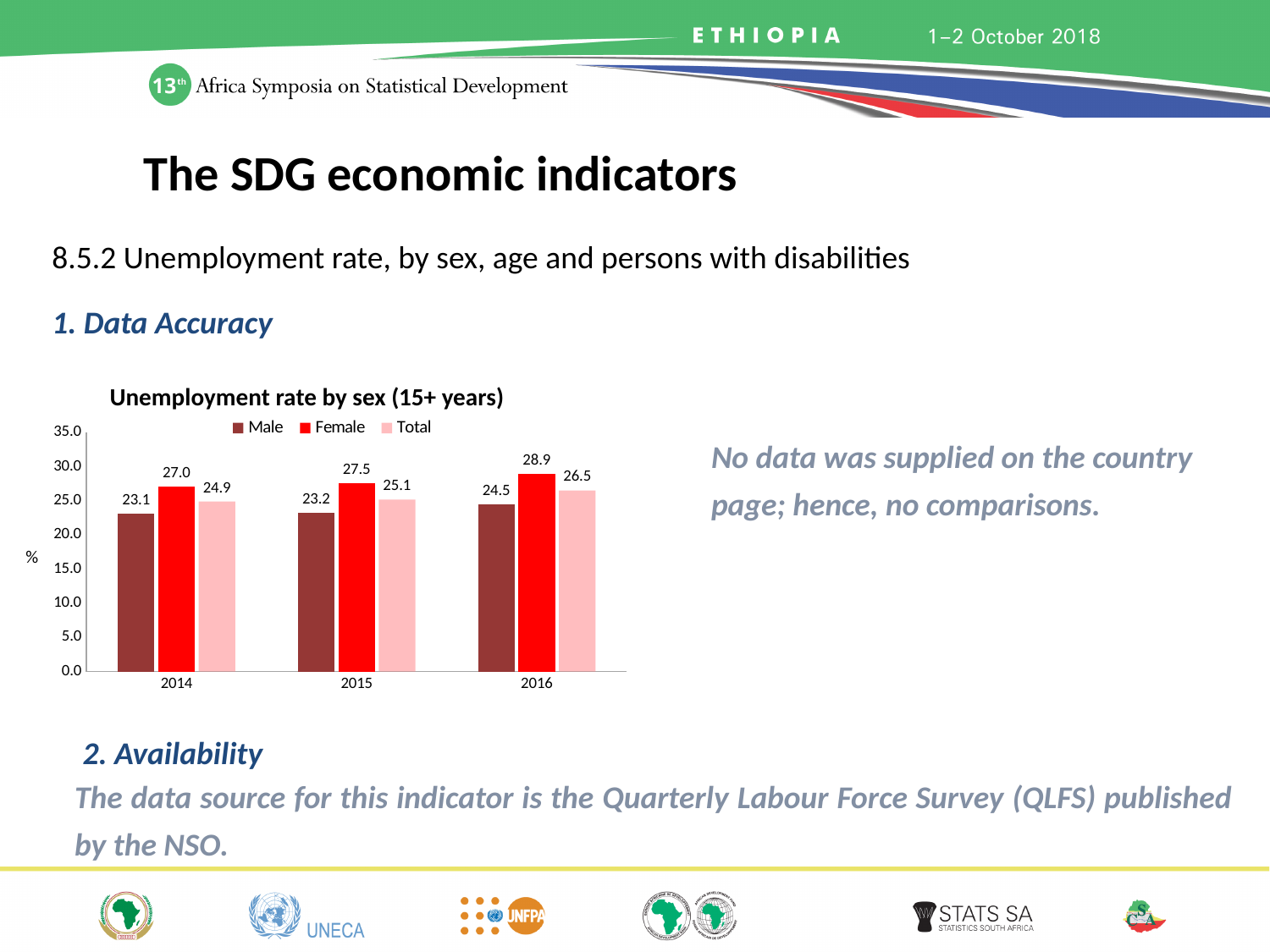
How many years are shown on the x axis? 3 What is the Total unemployment rate in 2015? 25.1 Which is larger in 2015, the Female rate or the Total rate? Female Is the Female unemployment rate in 2014 greater or less than 25.0? greater Does the Total unemployment rate rise or fall from 2014 to 2016? rise In which year is the Female unemployment rate highest? 2016 How many series does the legend list? 3 What is the Female unemployment rate in 2016? 28.9 What is the difference between the Female and Male unemployment rates in 2016? 4.4 What kind of chart is shown? bar chart In which year is the Male unemployment rate lowest? 2014 What is the Male unemployment rate in 2014? 23.1